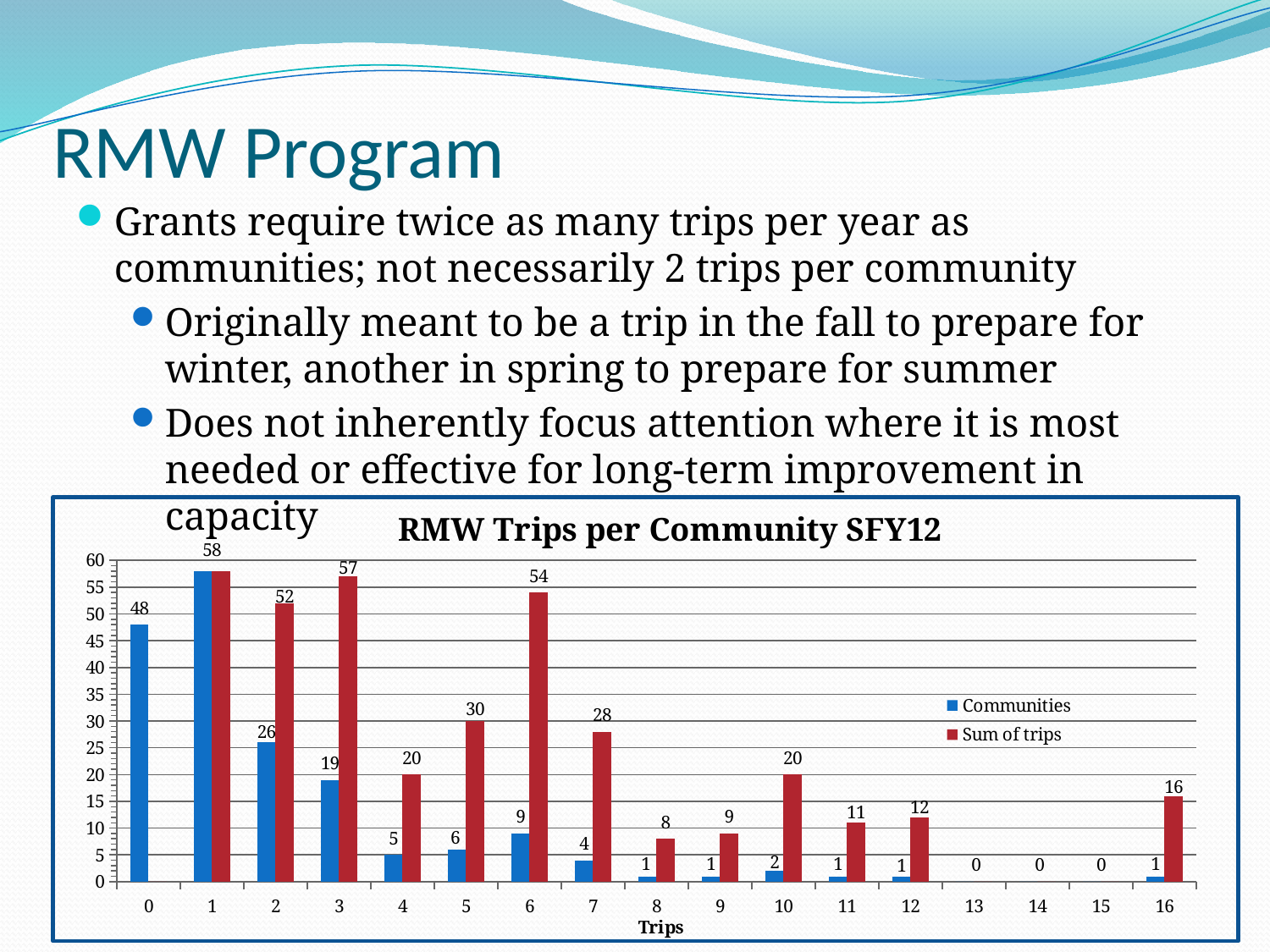
How many series does the chart legend list? 2 How many trip categories are shown along the x axis of the chart? 17 What type of chart is shown on the slide? bar chart What is the Communities value for 2 trips? 26 What is the title of the chart? RMW Trips per Community SFY12 What is the difference between the Sum of trips and Communities values for 2 trips? 26 What is the Sum of trips value for 3 trips? 57 Which trips category has the highest Communities value? 1 Which series is shown in red in the chart? Sum of trips What is the Sum of trips value for 6 trips? 54 Which is larger, the Sum of trips value for 5 trips or for 7 trips? 5 trips What is the Communities value for 0 trips? 48